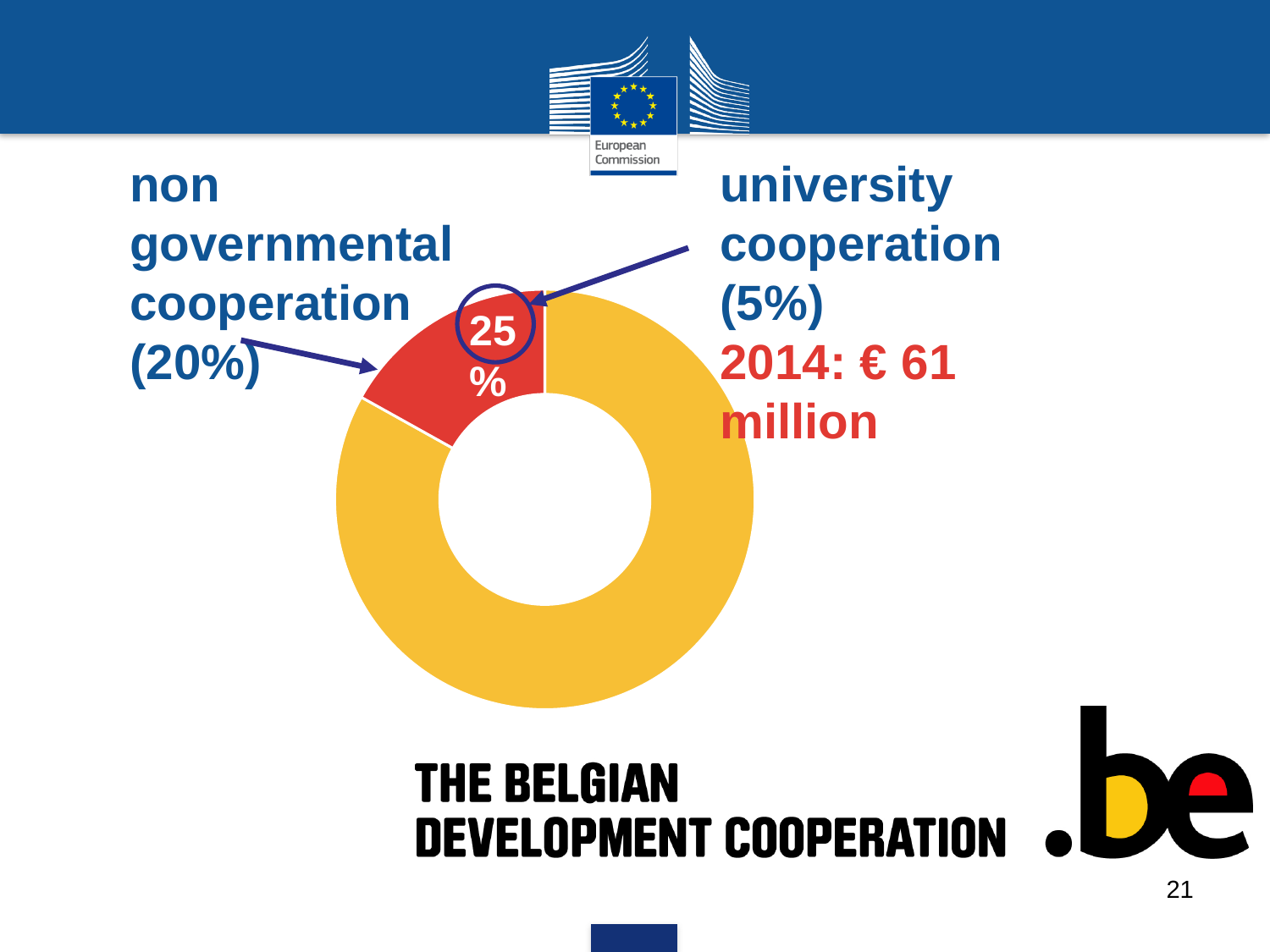
According to the annotation, what percentage is attributed to university cooperation? 5% What kind of chart is shown on the slide? doughnut (pie) chart Which of the two annotated components is larger, non governmental cooperation or university cooperation? non governmental cooperation How many slices does the doughnut chart have? 2 What share of the doughnut does the red slice represent? 25% What amount is given for 2014 next to the chart? € 61 million What is the difference between the non governmental cooperation share (20%) and the university cooperation share (5%)? 15% What colour is the slice labelled 25%? red Which slice of the doughnut chart is larger, the yellow one or the red one? the yellow one What percentage is printed on the red slice of the doughnut chart? 25% What is the combined share of non governmental cooperation (20%) and university cooperation (5%)? 25% According to the annotation, what percentage is attributed to non governmental cooperation? 20%